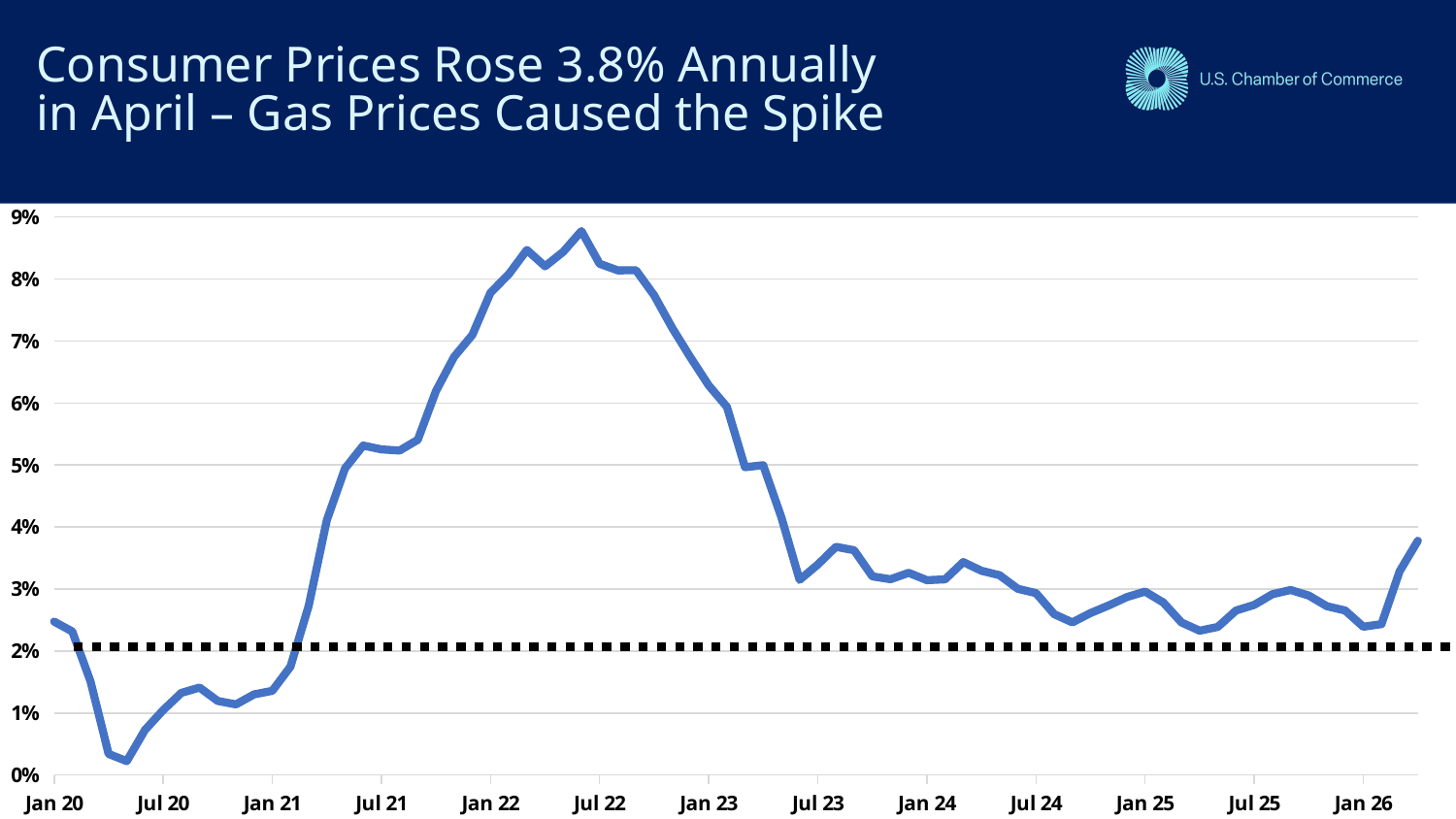
Is the value at Jan 20 greater or less than 2%? greater Does the line rise or fall between Jul 22 and Jul 23? fall What kind of chart is shown on the slide? line chart At what level is the horizontal dotted line drawn? 2% Is the value at Jul 22 greater or less than 8%? greater Is the value at Jul 25 greater or less than 3%? less In which year does the line reach its lowest point? 2020 According to the slide title, by how much did consumer prices rise annually in April? 3.8% In which year does the line reach its highest point? 2022 How many date labels are shown on the x axis? 13